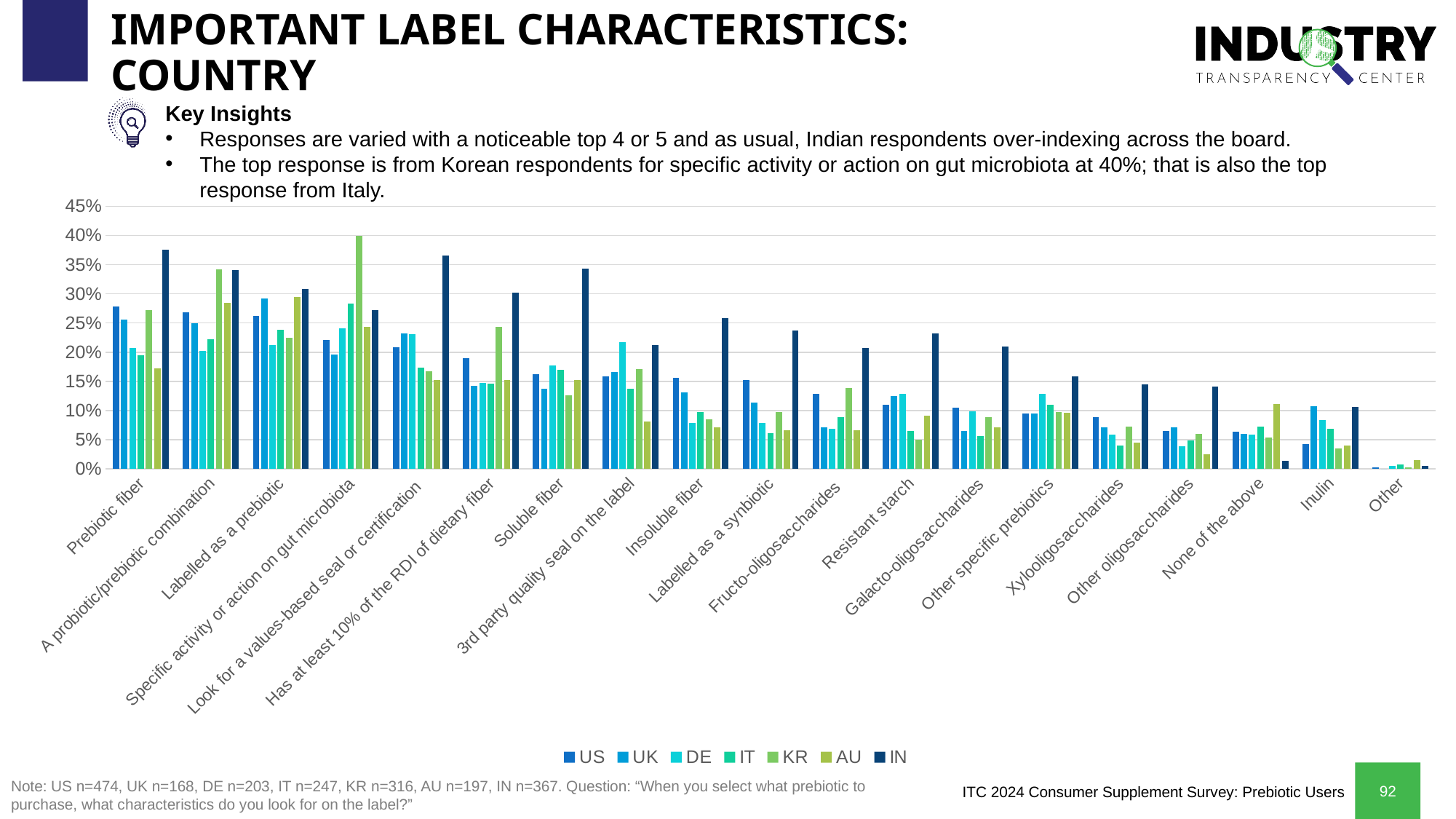
Is the IN value for 'Look for a values-based seal or certification' greater or less than 35%? greater Which country has the highest value for 'Prebiotic fiber'? IN Which country has the highest value for 'Specific activity or action on gut microbiota'? KR Do the US values generally rise or fall moving from left to right along the x axis? fall How many series does the legend list? 7 Is the IN value for 'Prebiotic fiber' greater or less than 35%? greater What is the KR value for 'Specific activity or action on gut microbiota'? 40% For 'Specific activity or action on gut microbiota', which is larger, the KR value or the IN value? KR How many label characteristic categories are shown on the x axis? 19 Which country has the lowest value for 'Prebiotic fiber'? AU What kind of chart is shown on the slide? bar chart Is the IN value for 'Other' greater or less than 5%? less